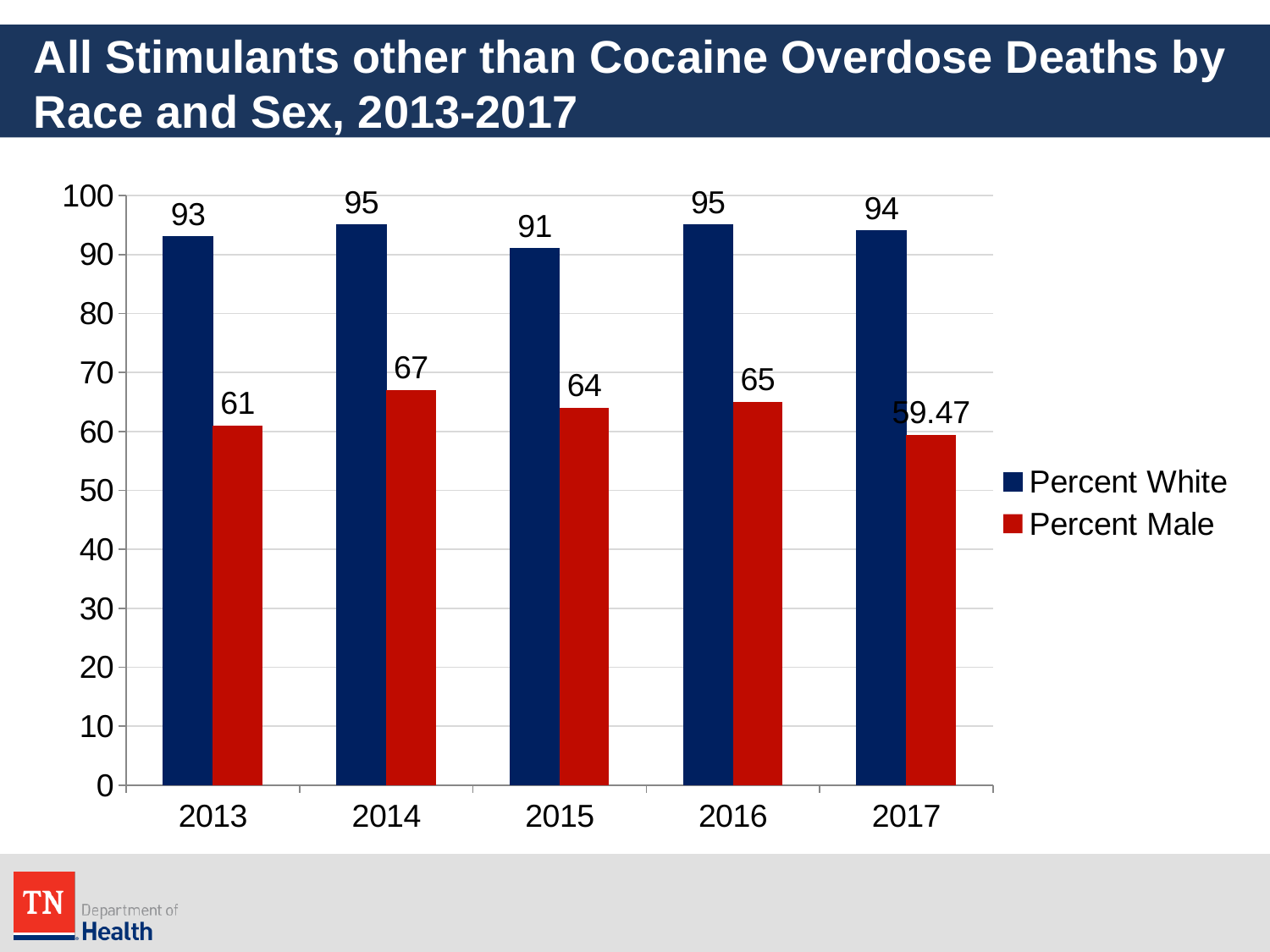
Is the Percent Male value for 2017 greater or less than 60? less How many years are shown on the x axis? 5 What is the Percent Male value for 2017? 59.47 What is the difference between Percent White and Percent Male in 2015? 27 How many series does the legend list? 2 Which is larger, the Percent Male value for 2013 or for 2016? 2016 What kind of chart is shown on the slide? bar chart Which colour represents Percent Male in the chart? red Which year has the lowest Percent White value? 2015 What is the Percent Male value for 2014? 67 What is the Percent White value for 2013? 93 Which year has the highest Percent Male value? 2014